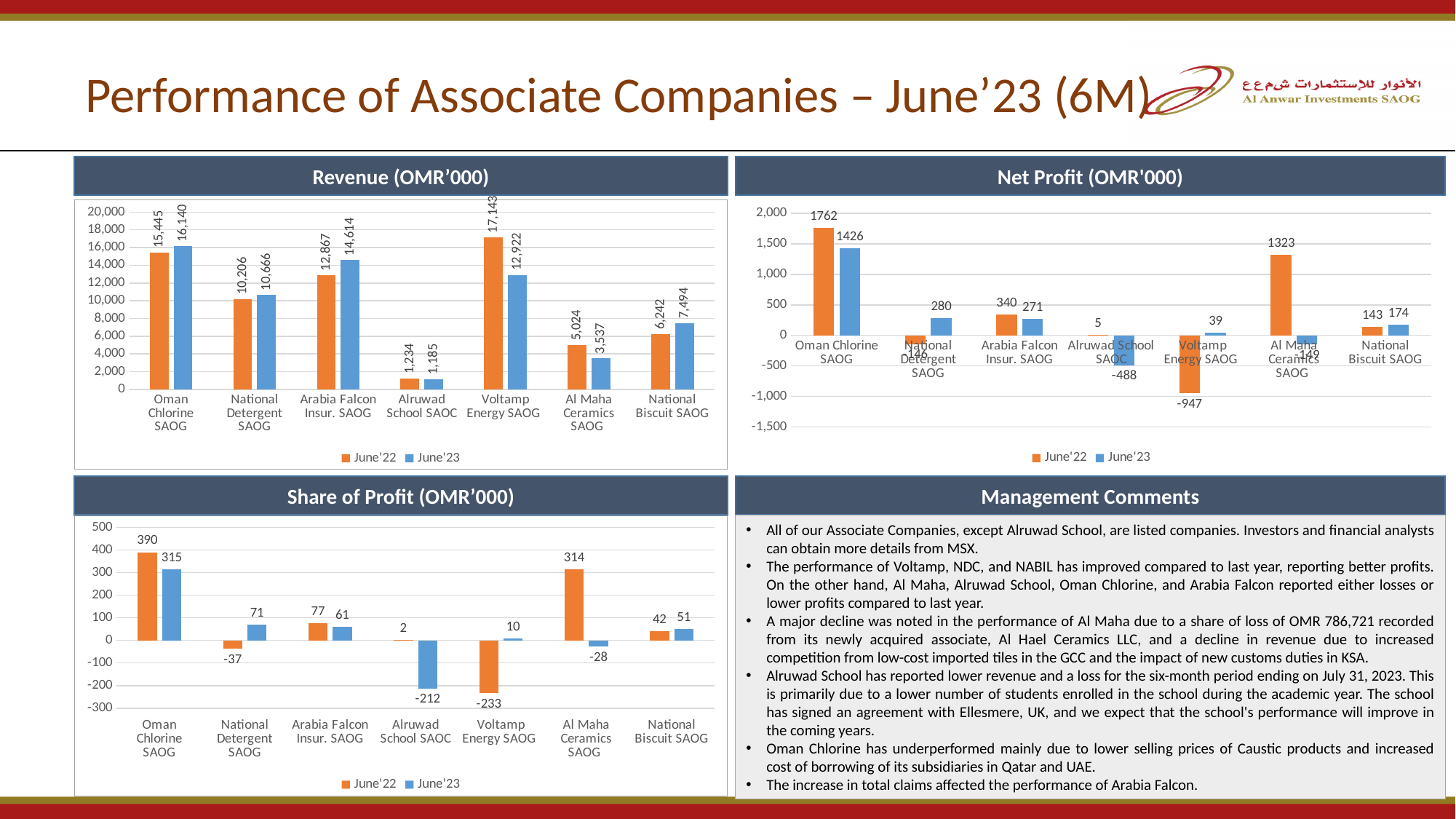
What type of chart is the Revenue (OMR'000) chart? Bar chart In the Revenue (OMR'000) chart, which company has the lowest June'23 revenue? Alruwad School SAOC In the Share of Profit (OMR'000) chart, what is the June'23 share of profit for Alruwad School SAOC? -212 How many companies are shown in the Share of Profit (OMR'000) chart? 7 How many series does the legend of the Net Profit (OMR'000) chart list? 2 In the Revenue (OMR'000) chart, what is the June'23 revenue for Arabia Falcon Insur. SAOG? 14,614 In the Net Profit (OMR'000) chart, what is the June'23 net profit for National Detergent SAOG? 280 In the Net Profit (OMR'000) chart, is the June'22 net profit for Oman Chlorine SAOG larger or the June'23 net profit? June'22 In the Share of Profit (OMR'000) chart, what is the difference between the June'22 and June'23 share of profit for Oman Chlorine SAOG? 75 In the Revenue (OMR'000) chart, which company has the highest June'22 revenue? Voltamp Energy SAOG In the Net Profit (OMR'000) chart, which company has the lowest June'22 net profit? Voltamp Energy SAOG In the Revenue (OMR'000) chart, what is the difference between the June'22 and June'23 revenue for Voltamp Energy SAOG? 4,221